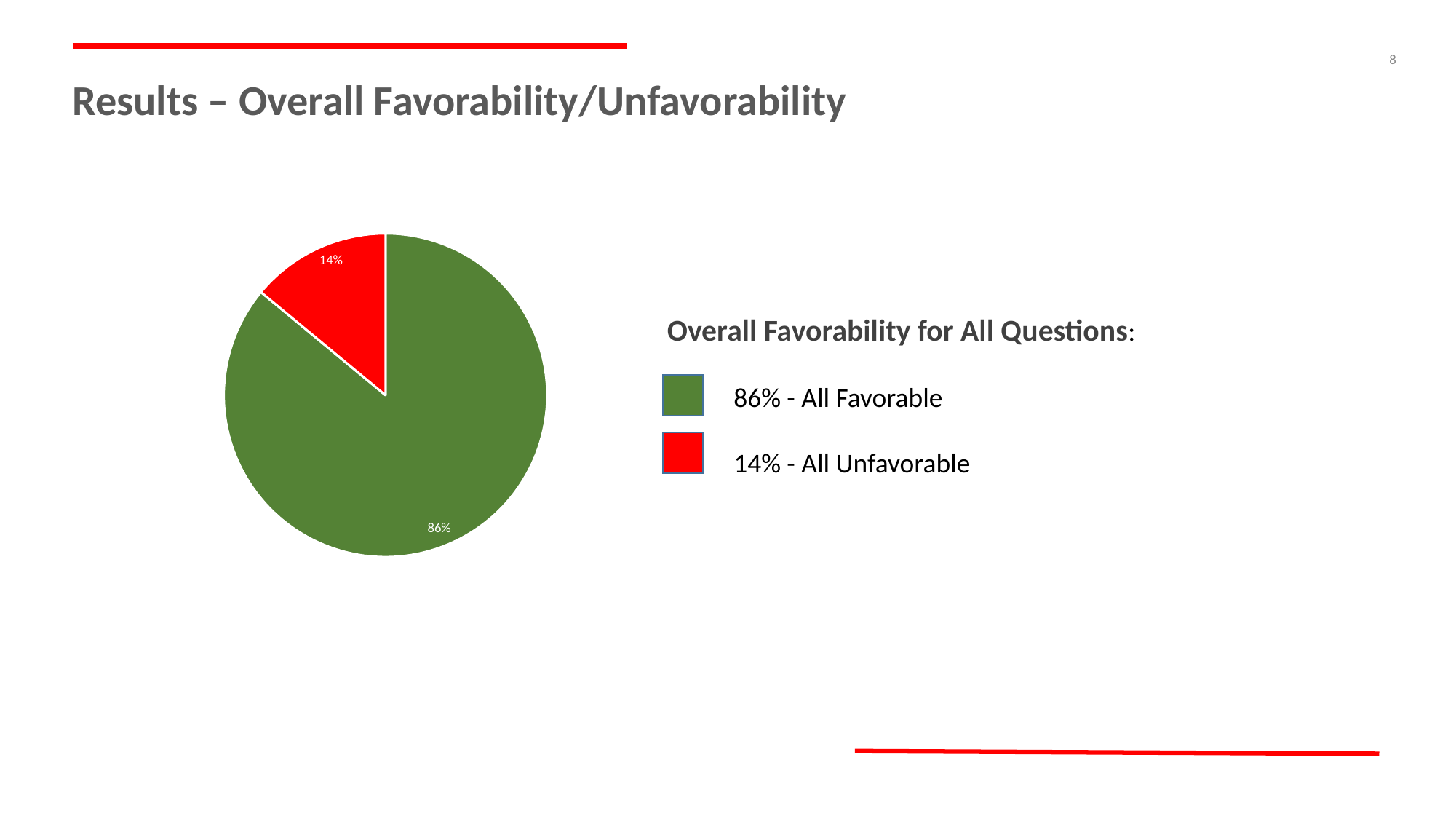
What is the total of the two slices shown in the pie chart? 100% What colour is the All Favorable slice? green What kind of chart is shown on the slide? pie chart What share of the pie is All Unfavorable? 14% What colour is the All Unfavorable slice? red Which is larger, the All Favorable slice or the All Unfavorable slice? All Favorable Which slice of the pie is the smallest? All Unfavorable What share of the pie is All Favorable? 86% What is the difference in percentage points between the All Favorable and All Unfavorable slices? 72 How many slices does the pie chart have? 2 Which slice of the pie is the largest? All Favorable